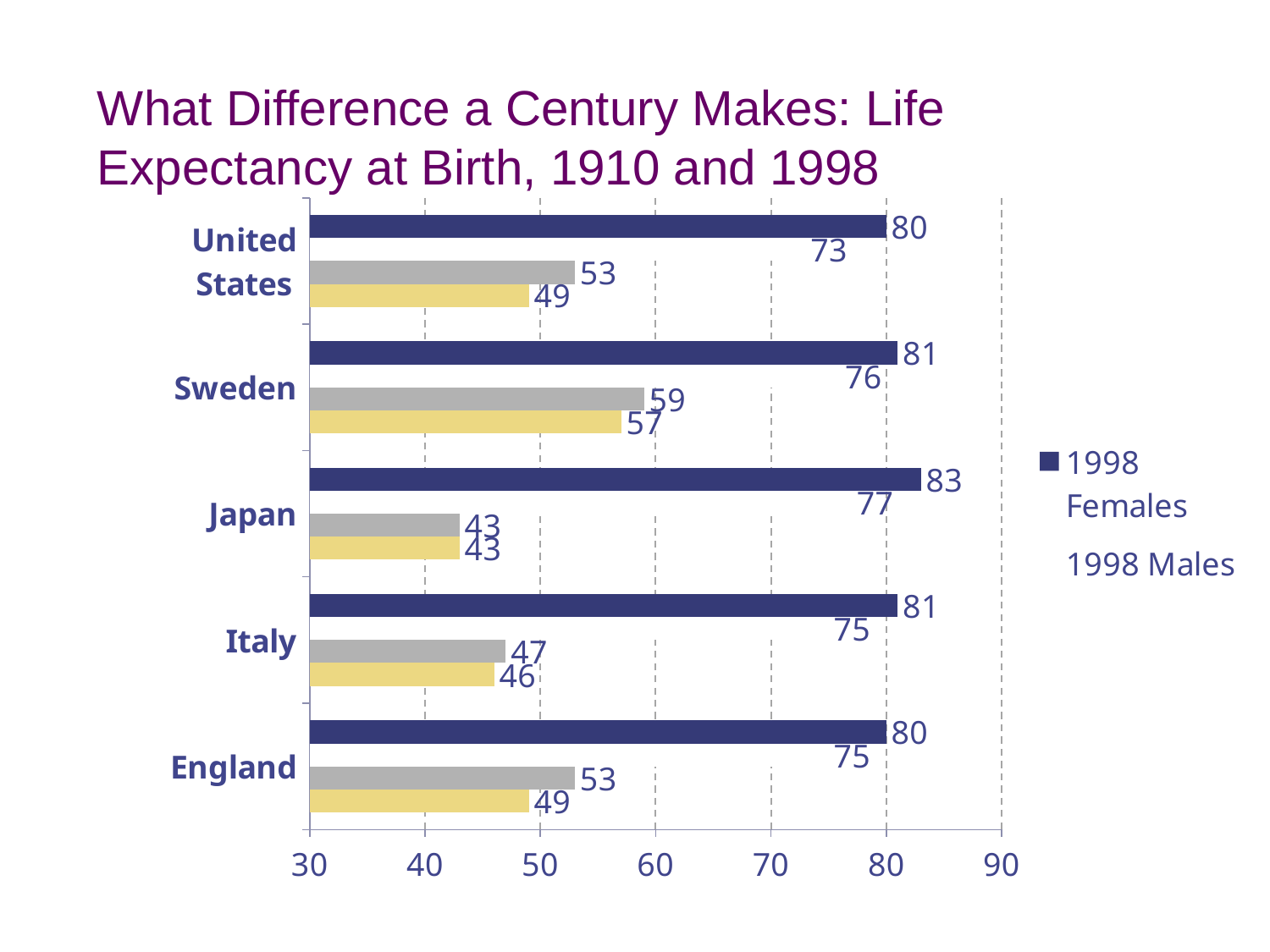
What is the 1998 Females value for Japan? 83 How many countries are shown on the chart? 5 What is the 1998 Males value for Sweden? 76 What is the difference between the 1998 Females and 1998 Males values for Japan? 6 What kind of chart is shown on the slide? Bar chart Which is larger, the gray bar for the United States or the gray bar for Sweden? Sweden What value is labelled on the gray bar for Sweden? 59 Which country has the highest 1998 Females value? Japan What value is labelled on the yellow bar for Italy? 46 What is the title of the slide? What Difference a Century Makes: Life Expectancy at Birth, 1910 and 1998 How many series does the legend list? 2 Which country has the lowest value on the gray bars? Japan